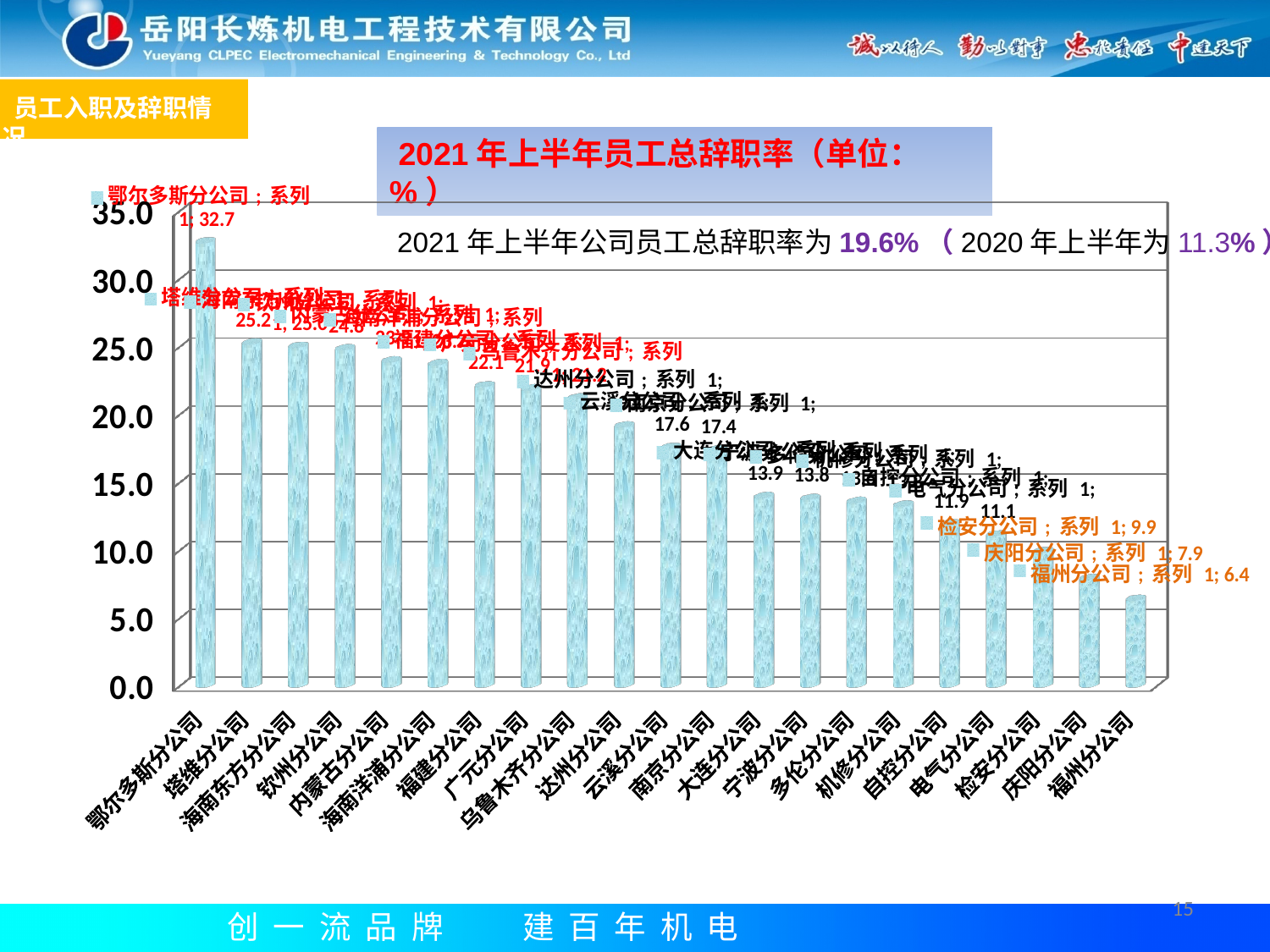
What is the value for 福州分公司? 6.4 What is the value for 鄂尔多斯分公司? 32.7 What is the title of the chart? 2021年上半年员工总辞职率（单位：%） Which is larger, the value for 检安分公司 or 庆阳分公司? 检安分公司 Do the values rise or fall moving from left to right along the x axis? fall What is the difference between the values for 鄂尔多斯分公司 and 福州分公司? 26.3 What is the value for 检安分公司? 9.9 Which branch company has the lowest resignation rate? 福州分公司 What is the value for 庆阳分公司? 7.9 Which branch company has the highest resignation rate? 鄂尔多斯分公司 What kind of chart is shown on the slide? bar chart How many branch companies (categories) are plotted on the x axis? 21